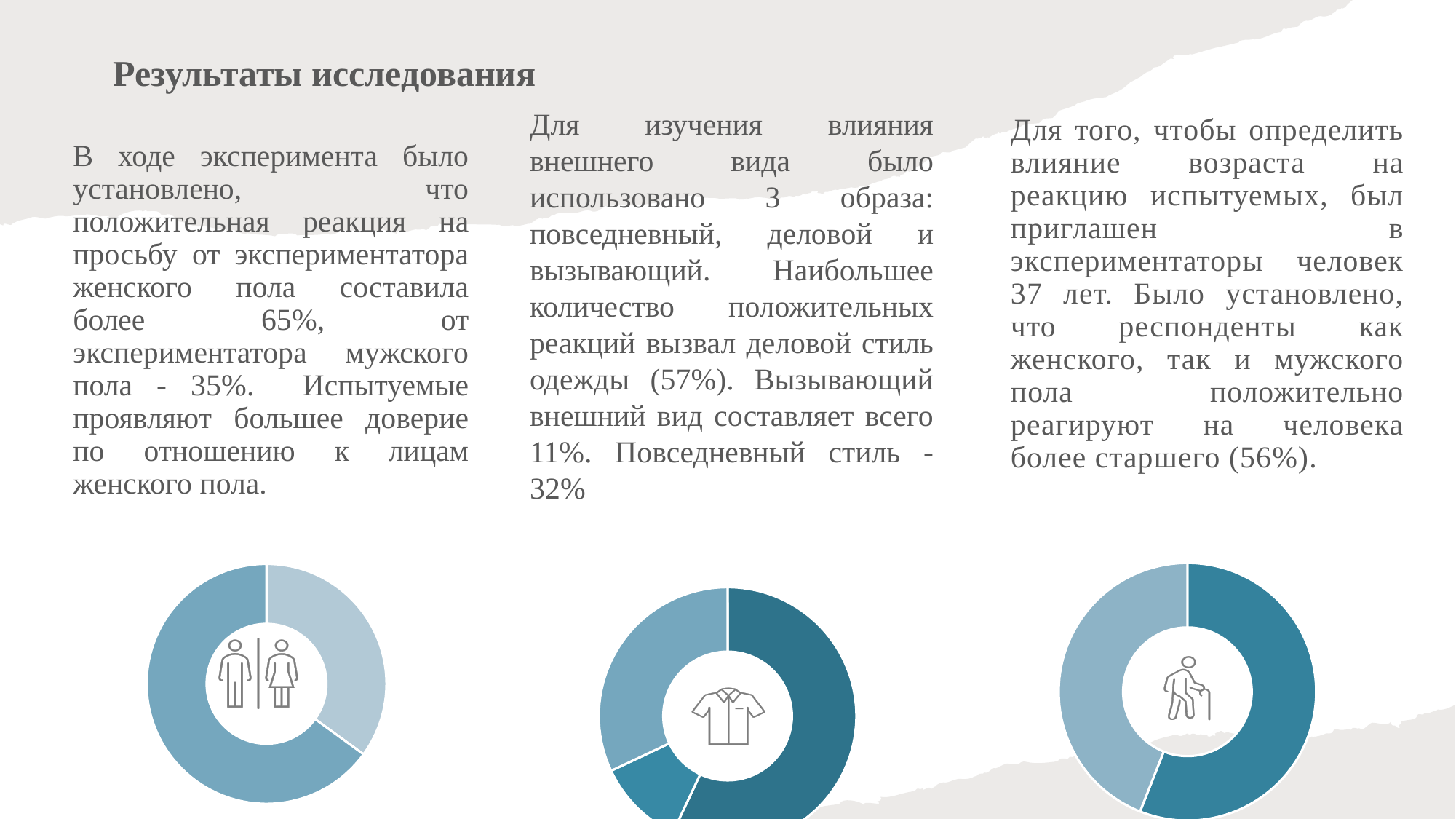
What kind of chart is the left chart on the slide? pie (donut) chart How many charts are shown on the slide? 3 In the middle chart, which is larger: the light blue slice or the small dark slice at the bottom? the light blue slice What icon is shown in the centre of the right chart? an elderly person with a cane In the left chart, which slice is larger: the darker blue slice or the lighter blue slice? the darker blue slice In the right chart, which slice is larger: the dark teal slice or the light blue slice? the dark teal slice How many slices does the middle chart (with the shirt icon) have? 3 How many slices does the left chart (with the man/woman icon) have? 2 In the middle chart, which slice is the largest? the dark blue slice on the right What icon is shown in the centre of the middle chart? a shirt In the middle chart, which slice is the smallest? the small dark slice at the bottom left